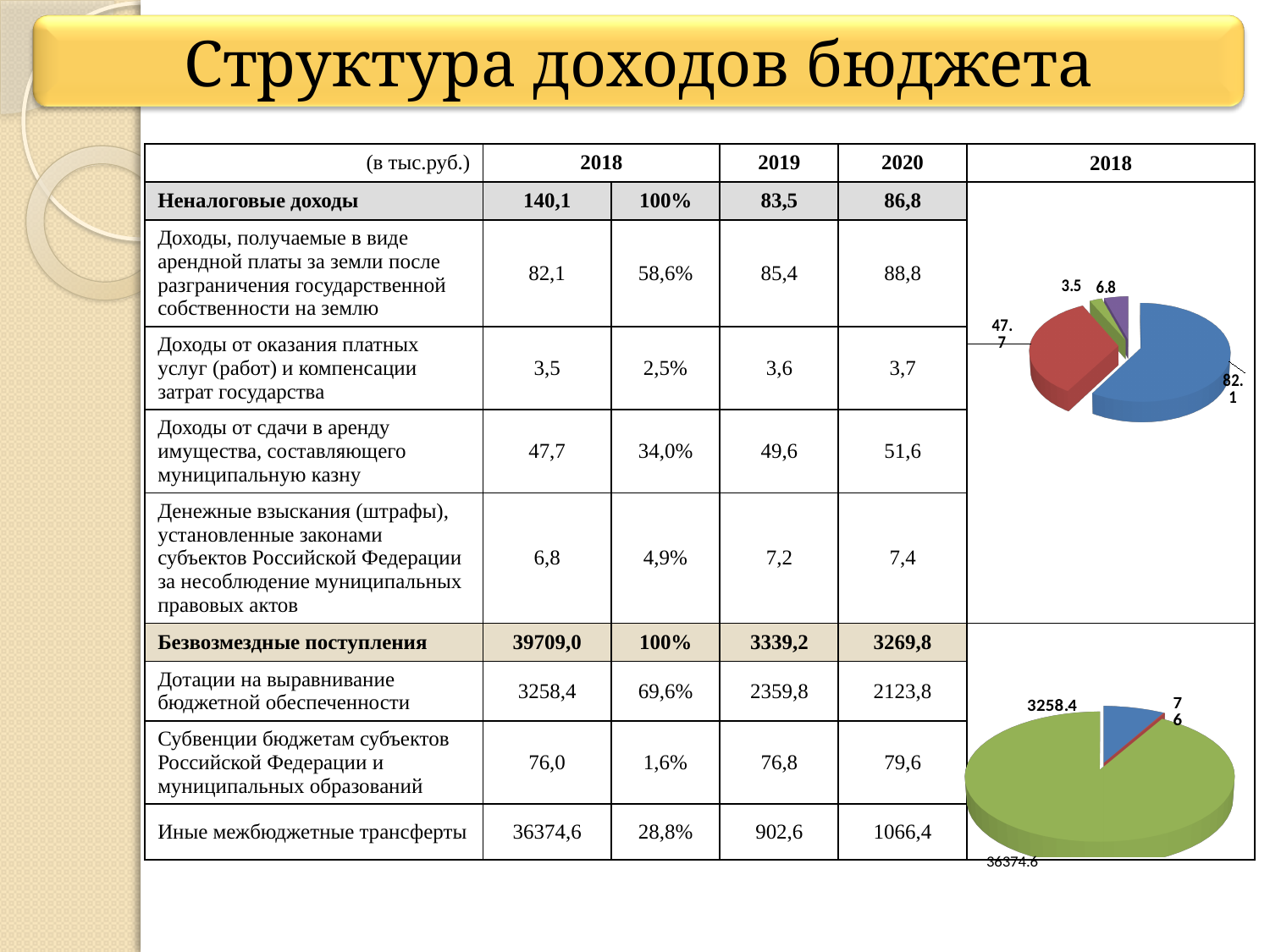
In the lower pie chart, what is the value of the largest slice? 36374.6 In the upper pie chart, what is the value of the blue slice? 82.1 In the lower pie chart, what is the value of the smallest slice? 76 In the upper pie chart, which slice is larger: the one labelled 47.7 or the one labelled 6.8? 47.7 How many slices does the upper pie chart have? 4 In the lower pie chart, what is the value of the green slice? 36374.6 In the upper pie chart, what is the value of the largest slice? 82.1 In the upper pie chart, what is the difference between the slice labelled 82.1 and the slice labelled 47.7? 34.4 How many slices does the lower pie chart have? 3 In the upper pie chart, what is the value of the smallest slice? 3.5 What kind of chart is the upper chart on the right of the slide? pie chart Which year is shown in the header above the pie charts? 2018